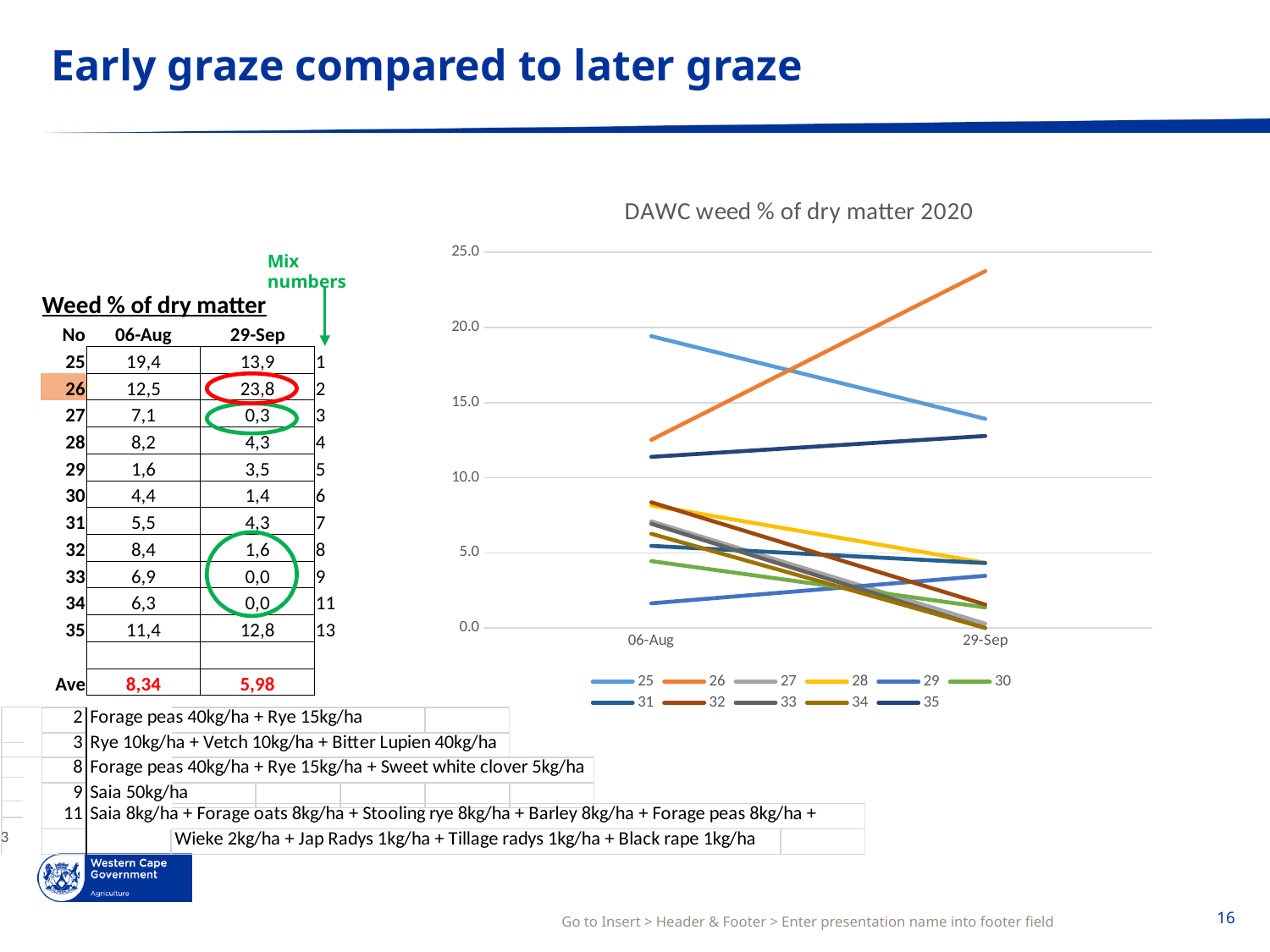
How many series does the legend of the "DAWC weed % of dry matter 2020" chart list? 11 What is the title of the line chart on the slide? DAWC weed % of dry matter 2020 In the "DAWC weed % of dry matter 2020" chart, which series has the highest value on 06-Aug? 25 In the "DAWC weed % of dry matter 2020" chart, does series 26 rise or fall from 06-Aug to 29-Sep? rise In the "DAWC weed % of dry matter 2020" chart, which series has the highest value on 29-Sep? 26 What kind of chart is "DAWC weed % of dry matter 2020"? line chart In the "DAWC weed % of dry matter 2020" chart, is the value for series 35 on 06-Aug greater or less than 10.0? greater How many dates are shown on the x axis of the "DAWC weed % of dry matter 2020" chart? 2 According to the table on the slide, what is the weed % of dry matter for mix 26 on 29-Sep? 23,8 In the "DAWC weed % of dry matter 2020" chart, does series 25 rise or fall from 06-Aug to 29-Sep? fall In the "DAWC weed % of dry matter 2020" chart, is the value for series 26 on 29-Sep greater or less than 20.0? greater In the "DAWC weed % of dry matter 2020" chart, which is larger on 06-Aug: series 25 or series 26? 25